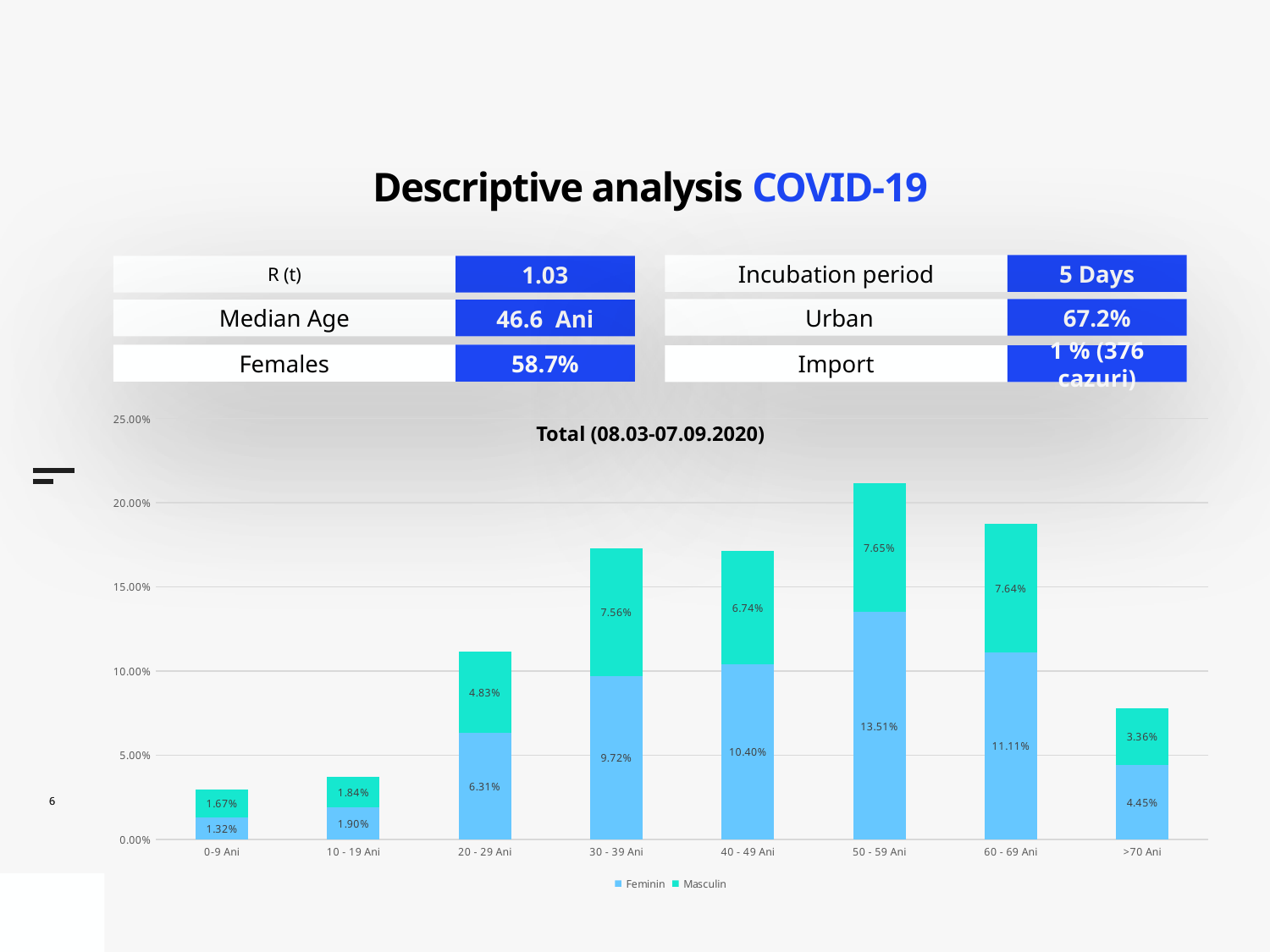
Which is larger for the 40 - 49 Ani group, the Feminin value or the Masculin value? Feminin How many age groups are shown on the x axis? 8 What is the Feminin value for the >70 Ani age group? 4.45% What is the difference between the Feminin values for 50 - 59 Ani and 60 - 69 Ani? 2.40% How many series does the legend list? 2 Which age group has the lowest Masculin value? 0-9 Ani What is the Masculin value for the 20 - 29 Ani age group? 4.83% Is the total stacked value for the 50 - 59 Ani bar greater or less than 20.00%? greater What is the total stacked value for the 0-9 Ani bar? 2.99% What is the Feminin value for the 50 - 59 Ani age group? 13.51% What kind of chart is shown on the slide? Stacked bar chart Which age group has the highest Feminin value? 50 - 59 Ani